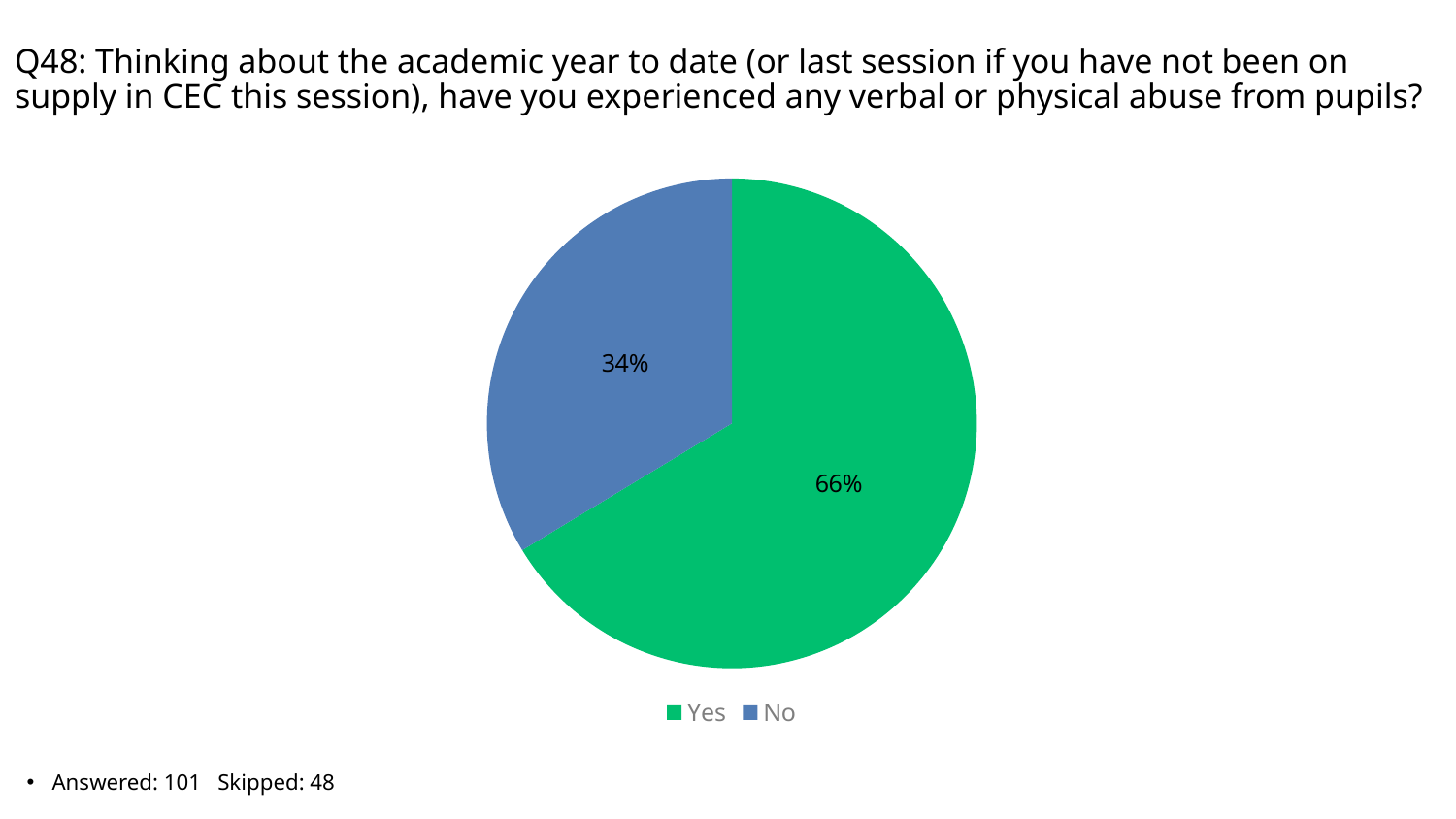
What share of the pie does the No slice represent? 34% What percentage of respondents answered Yes? 66% Which response has the smallest share of the pie? No Which slice is larger, Yes or No? Yes Which response has the largest share of the pie? Yes How many respondents answered this question according to the slide? 101 How many entries does the legend list? 2 What is the difference in percentage points between the Yes and No slices? 32 What percentage of respondents answered No? 34% How many slices does the pie chart have? 2 What colour is the Yes slice? green What kind of chart is shown on the slide? pie chart